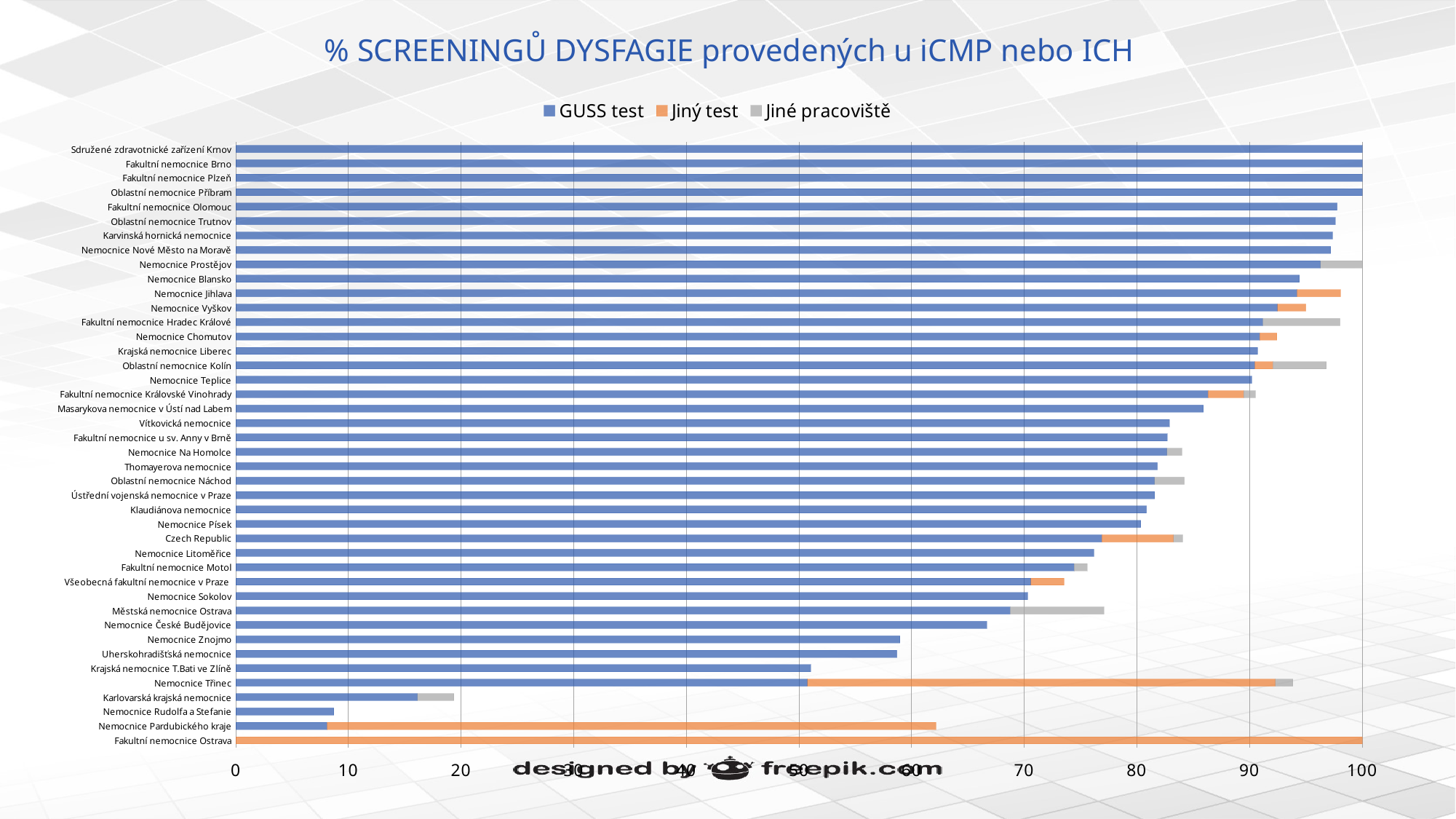
How many categories (hospitals) are plotted on the chart? 42 Which category has the lowest GUSS test value? Fakultní nemocnice Ostrava Is the GUSS test value for Nemocnice Třinec greater or less than 60? less What is the title of the chart? % SCREENINGŮ DYSFAGIE provedených u iCMP nebo ICH What kind of chart is shown on the slide? bar chart What is the GUSS test value for Sdružené zdravotnické zařízení Krnov? 100 What are the three series named in the legend? GUSS test, Jiný test, Jiné pracoviště Which has the larger GUSS test value, Nemocnice Znojmo or Nemocnice Sokolov? Nemocnice Sokolov What is the Jiný test value for Fakultní nemocnice Ostrava? 100 How many series does the legend list? 3 Is the GUSS test value for Karlovarská krajská nemocnice greater or less than 20? less Is the GUSS test value for Nemocnice Rudolfa a Stefanie greater or less than 10? less